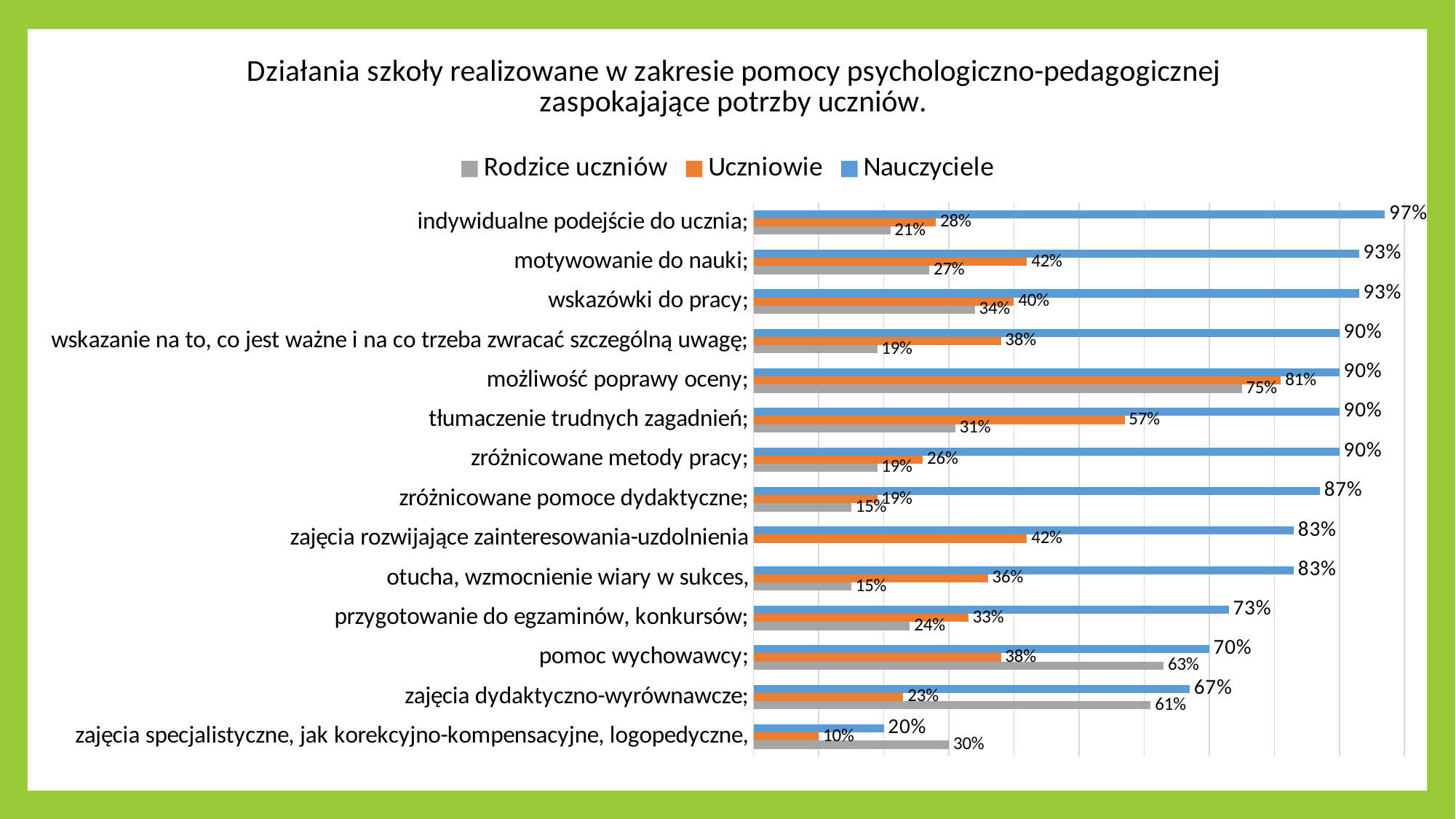
Which series is shown in orange in the legend? Uczniowie What is the difference between the Nauczyciele and Uczniowie values for 'możliwość poprawy oceny'? 9% How many categories are shown on the chart? 14 Which category has the highest value for Nauczyciele? indywidualne podejście do ucznia What is the value for Nauczyciele for 'indywidualne podejście do ucznia'? 97% Which category has the lowest value for Uczniowie? zajęcia specjalistyczne, jak korekcyjno-kompensacyjne, logopedyczne What is the value for Rodzice uczniów for 'pomoc wychowawcy'? 63% What kind of chart is shown on the slide? bar chart How many series does the legend list? 3 What is the value for Uczniowie for 'tłumaczenie trudnych zagadnień'? 57% Which category has the highest value for Rodzice uczniów? możliwość poprawy oceny For 'zajęcia specjalistyczne, jak korekcyjno-kompensacyjne, logopedyczne', which is larger: the value for Rodzice uczniów or for Nauczyciele? Rodzice uczniów